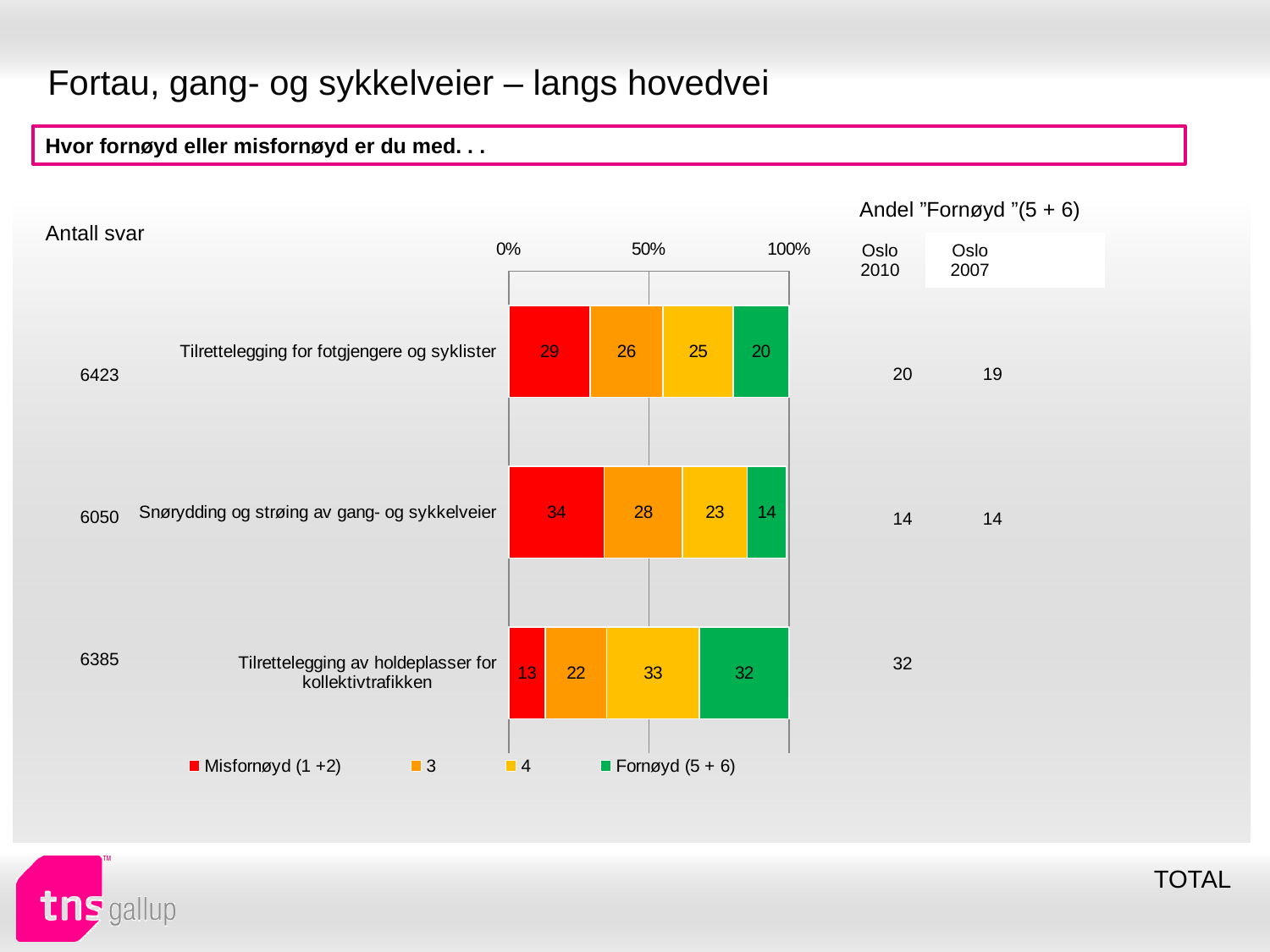
What colour represents the "Fornøyd (5 + 6)" series in the chart? Green What is the value of the "Fornøyd (5 + 6)" segment for "Tilrettelegging av holdeplasser for kollektivtrafikken"? 32 What is the value of the "Misfornøyd (1 +2)" segment for "Snørydding og strøing av gang- og sykkelveier"? 34 What is the value of the "4" segment for "Tilrettelegging for fotgjengere og syklister"? 25 How many series does the legend list? 4 How many categories are shown in the chart? 3 What is the total of the stacked bar for "Snørydding og strøing av gang- og sykkelveier"? 99 What kind of chart is shown on the slide? Stacked bar chart Which category has the lowest "Misfornøyd (1 +2)" value? Tilrettelegging av holdeplasser for kollektivtrafikken What is the difference between the "Misfornøyd (1 +2)" values for "Snørydding og strøing av gang- og sykkelveier" and "Tilrettelegging for fotgjengere og syklister"? 5 Which category has the highest "Fornøyd (5 + 6)" value? Tilrettelegging av holdeplasser for kollektivtrafikken Which is larger: the "3" segment for "Snørydding og strøing av gang- og sykkelveier" or the "3" segment for "Tilrettelegging av holdeplasser for kollektivtrafikken"? Snørydding og strøing av gang- og sykkelveier